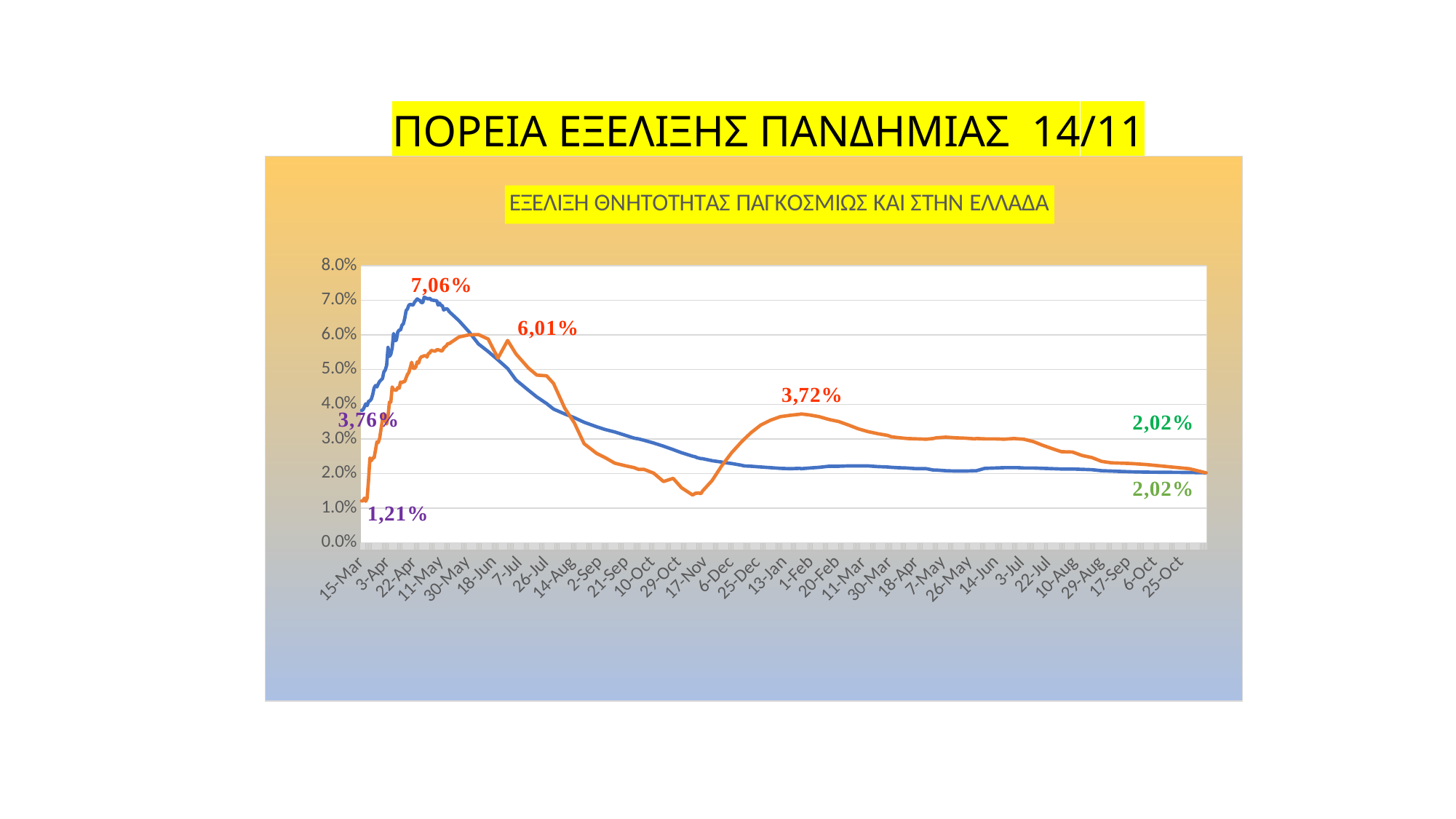
What is the labelled value of the orange line at its peak near 7-Jul? 6,01% What is the labelled peak value of the blue line? 7,06% What is the labelled starting value of the orange line at 15-Mar? 1,21% What is the labelled value of the orange line at its peak near 1-Feb? 3,72% Is the value of the blue line at 6-Dec greater or less than 3.0%? less What is the title of the chart? ΕΞΕΛΙΞΗ ΘΝΗΤΟΤΗΤΑΣ ΠΑΓΚΟΣΜΙΩΣ ΚΑΙ ΣΤΗΝ ΕΛΛΑΔΑ What is the labelled final value of the lines at the right end of the chart? 2,02% What kind of chart is shown on the slide? line chart What is the labelled starting value of the blue line at 15-Mar? 3,76% What is the difference between the blue line's labelled peak (7,06%) and the orange line's labelled peak near 7-Jul (6,01%)? 1,05% At 15-Mar, which line has the higher value, the blue line or the orange line? blue line How many lines are plotted on the chart? 2